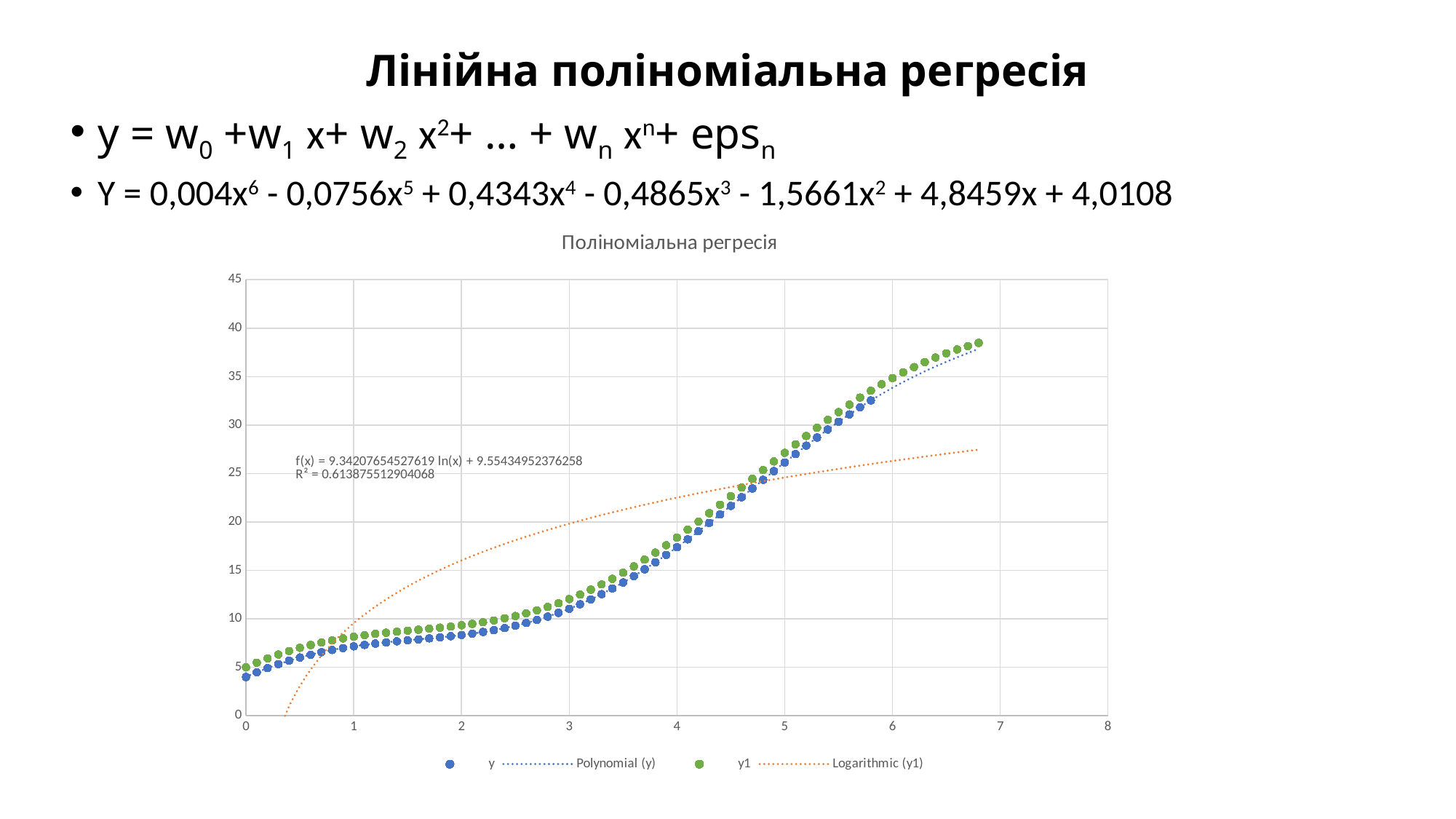
How many entries does the chart legend list? 4 What kind of chart is shown on the slide? scatter chart What R² value is printed on the chart for the logarithmic trendline? 0.613875512904068 Is the highest value of the y1 series greater or less than 35? greater Is the value of the y series at x = 0 greater or less than 5? less What is the title of the chart? Поліноміальна регресія Is the value of the Logarithmic (y1) trendline at x = 7 greater or less than 30? less What is the maximum value shown on the vertical axis? 45 What colour are the markers of the y1 series? green Do the values of the y series rise or fall as x increases? rise